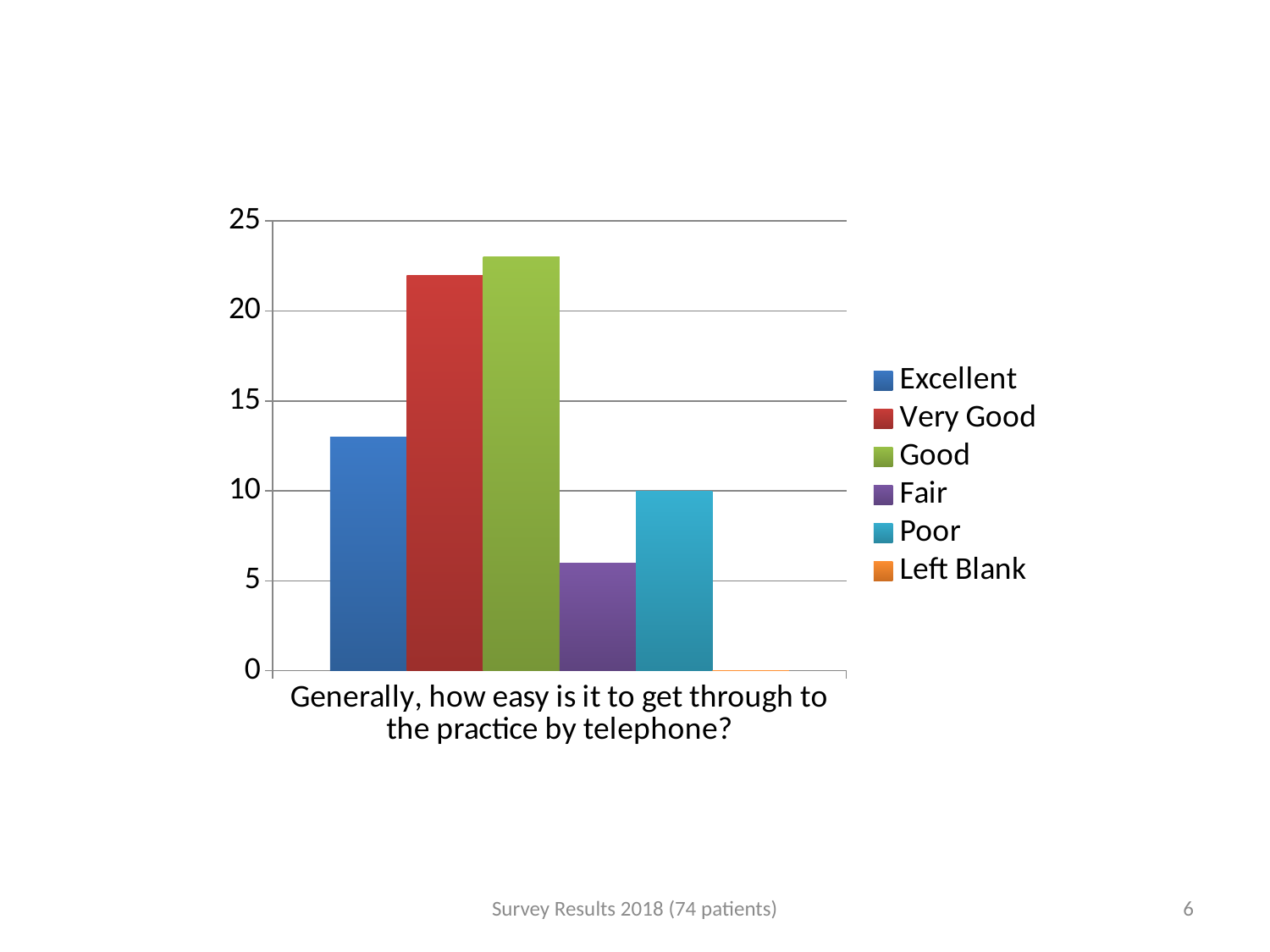
Is the value for Very Good greater or less than 20? greater Which series has the lowest value? Left Blank What is the highest value shown on the vertical axis? 25 Is the value for Excellent greater or less than 10? greater Is the value for Good greater or less than 20? greater What question is shown as the category label beneath the bars? Generally, how easy is it to get through to the practice by telephone? Which is larger, the value for Poor or the value for Very Good? Very Good What kind of chart is shown on the slide? bar chart How many series does the legend list? 6 Which is larger, the value for Excellent or the value for Fair? Excellent